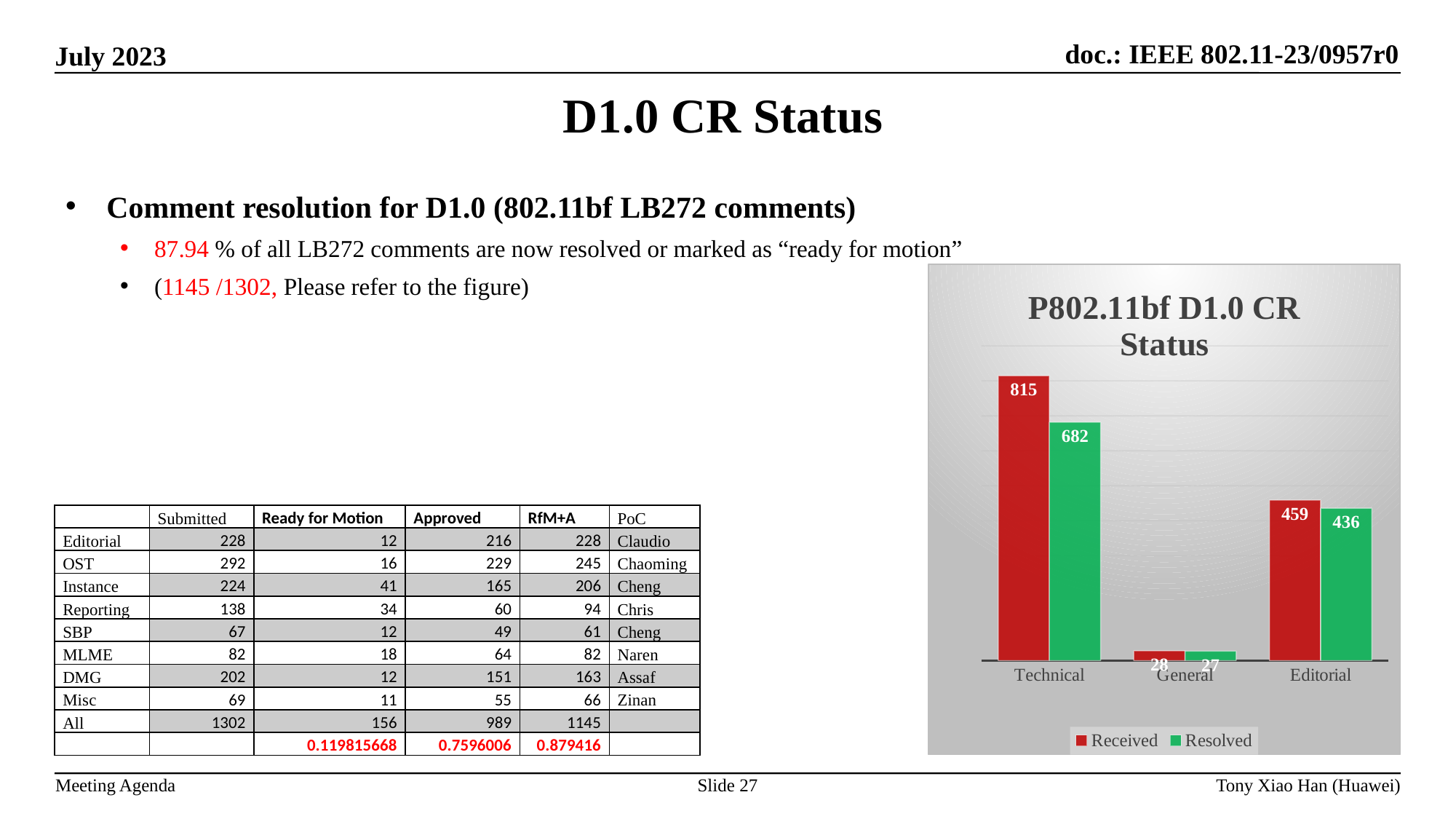
What is the difference between Received and Resolved for Technical? 133 What is the Received value for General? 28 What is the Resolved value for Technical? 682 Which category has the highest Received value? Technical What is the Received value for Technical? 815 What is the difference between Received and Resolved for Editorial? 23 How many categories are shown on the x axis? 3 What is the title of the chart? P802.11bf D1.0 CR Status How many series does the legend list? 2 What is the Resolved value for Editorial? 436 Which is larger, the Received value for Editorial or the Resolved value for Technical? Resolved value for Technical Which category has the lowest Resolved value? General